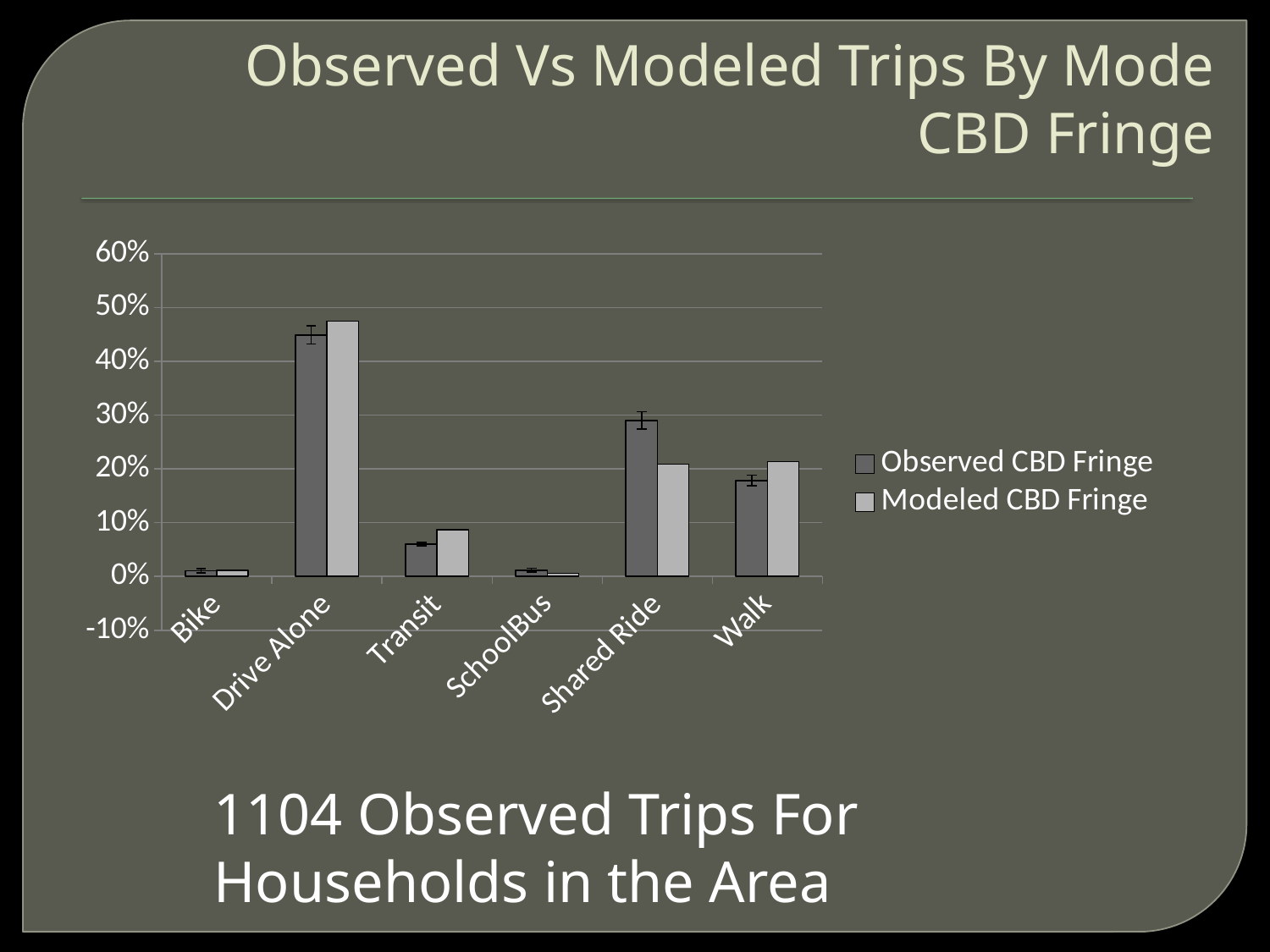
For Walk, which is larger: the Observed CBD Fringe value or the Modeled CBD Fringe value? Modeled CBD Fringe Which mode has the highest Modeled CBD Fringe value? Drive Alone What kind of chart is shown on the slide? bar chart Is the Observed CBD Fringe value for Drive Alone greater or less than 40%? greater Which mode has the highest Observed CBD Fringe value? Drive Alone How many series does the legend list? 2 For Transit, which is larger: the Observed CBD Fringe value or the Modeled CBD Fringe value? Modeled CBD Fringe How many mode categories are shown on the x axis? 6 What is the title of the chart slide? Observed Vs Modeled Trips By Mode CBD Fringe For Shared Ride, which is larger: the Observed CBD Fringe value or the Modeled CBD Fringe value? Observed CBD Fringe Is the Observed CBD Fringe value for Shared Ride greater or less than 20%? greater Is the Modeled CBD Fringe value for Transit greater or less than 10%? less